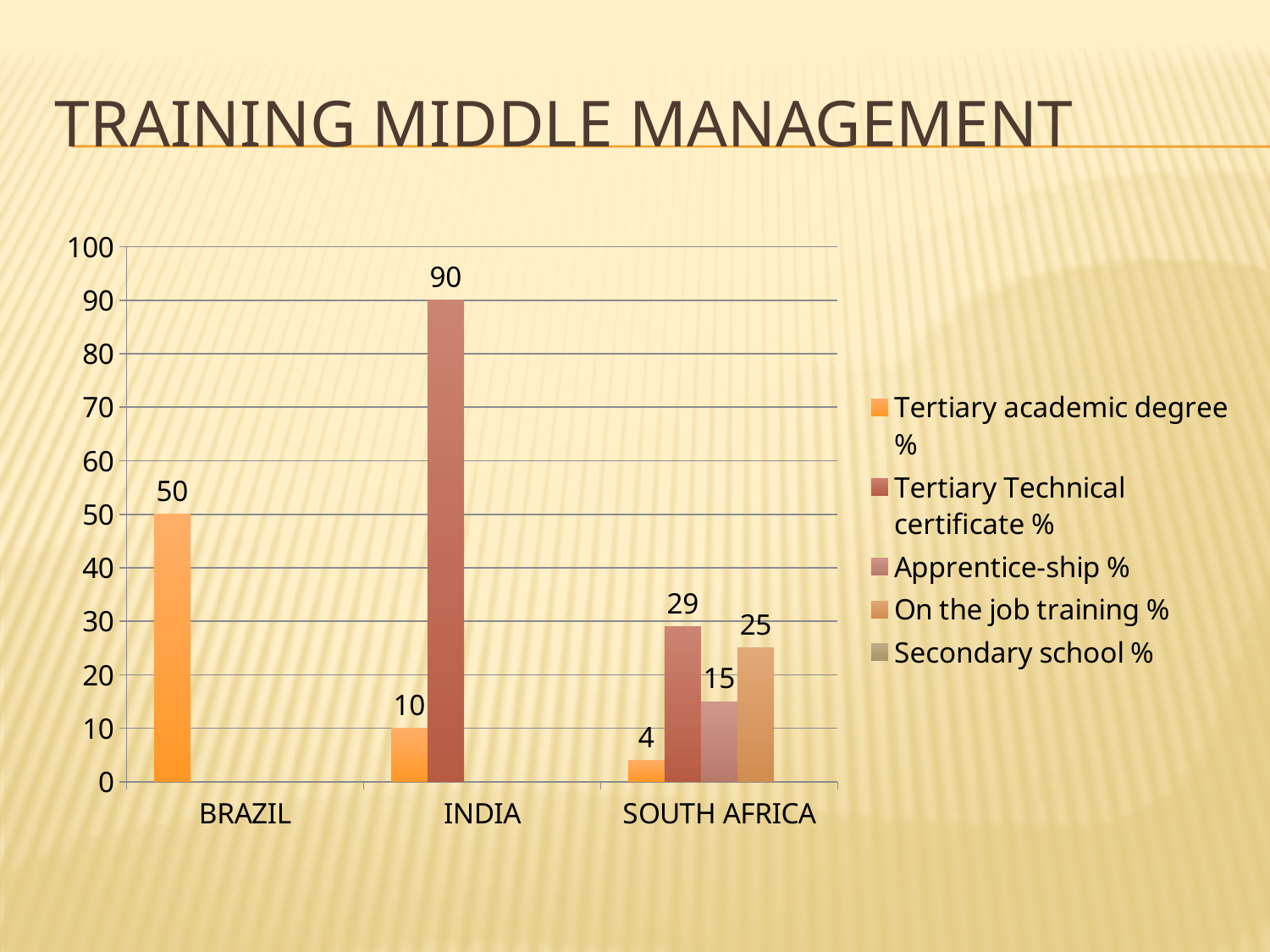
What is the Apprentice-ship % value for South Africa? 15 How many series does the legend list? 5 What is the Tertiary Technical certificate % value for India? 90 Which country has the lowest Tertiary academic degree % value? South Africa Which country has the highest Tertiary academic degree % value? Brazil What is the On the job training % value for South Africa? 25 What kind of chart is shown on the slide? Bar chart What is the title of the slide? Training Middle Management Which is larger: the Tertiary academic degree % for India or the On the job training % for South Africa? On the job training % for South Africa What is the difference between the Tertiary Technical certificate % values for India and South Africa? 61 How many countries are shown on the x axis? 3 What is the Tertiary academic degree % value for Brazil? 50